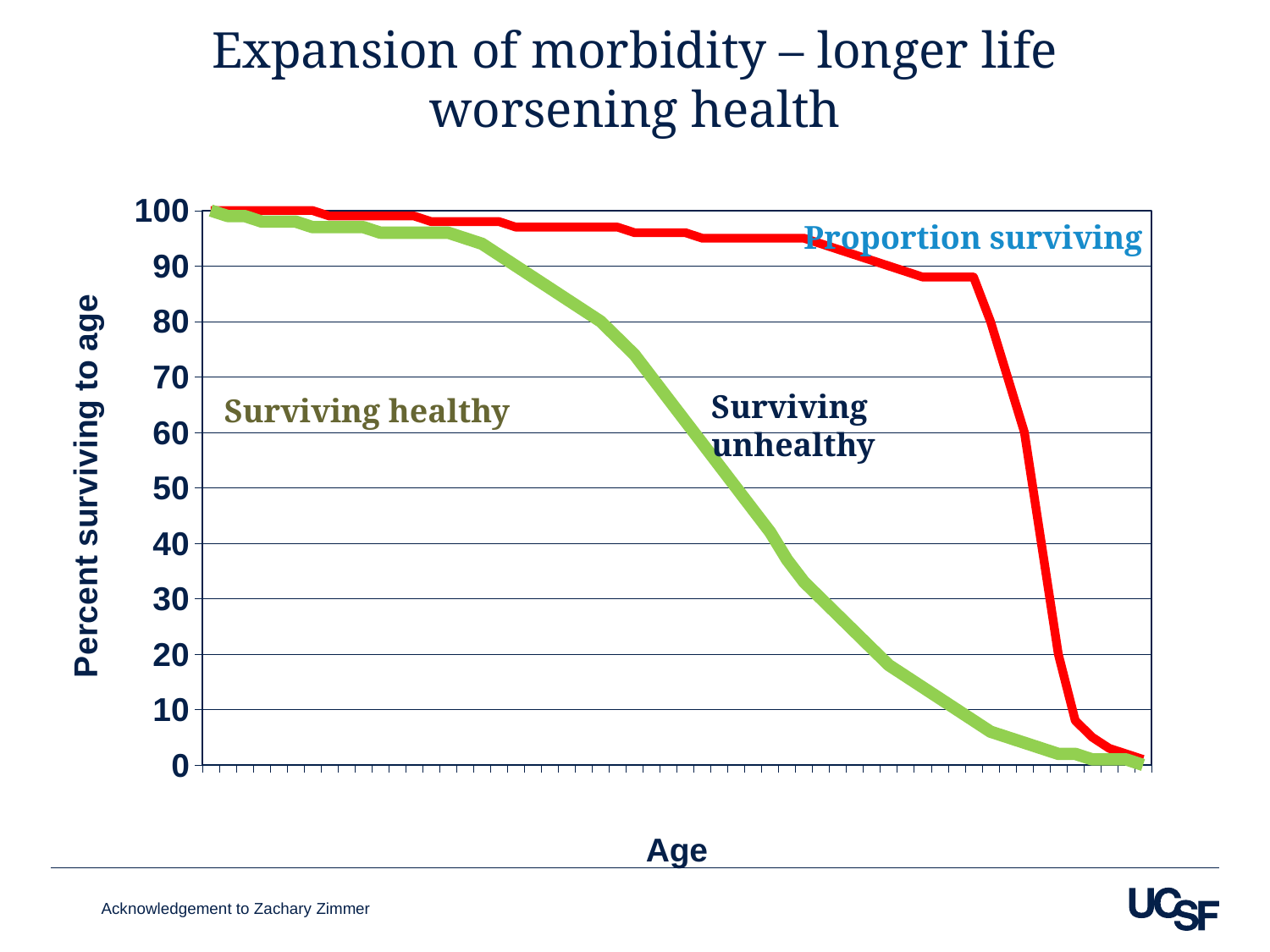
How many lines are plotted on the chart? 2 At the right end of the chart, is the value of the Surviving healthy line greater or less than 10? less At the left end of the chart, what value does the Proportion surviving line start at? 100 As age increases along the x axis, do the plotted values rise or fall? fall What is the highest value shown on the y axis? 100 Which line is higher across most of the age range, Proportion surviving or Surviving healthy? Proportion surviving What label appears in the area between the two lines? Surviving unhealthy Near the middle of the age axis, is the Proportion surviving line greater or less than 90? greater What is the title of the y axis? Percent surviving to age Which line begins to decline earlier along the age axis, Proportion surviving or Surviving healthy? Surviving healthy What kind of chart is shown on the slide? line chart